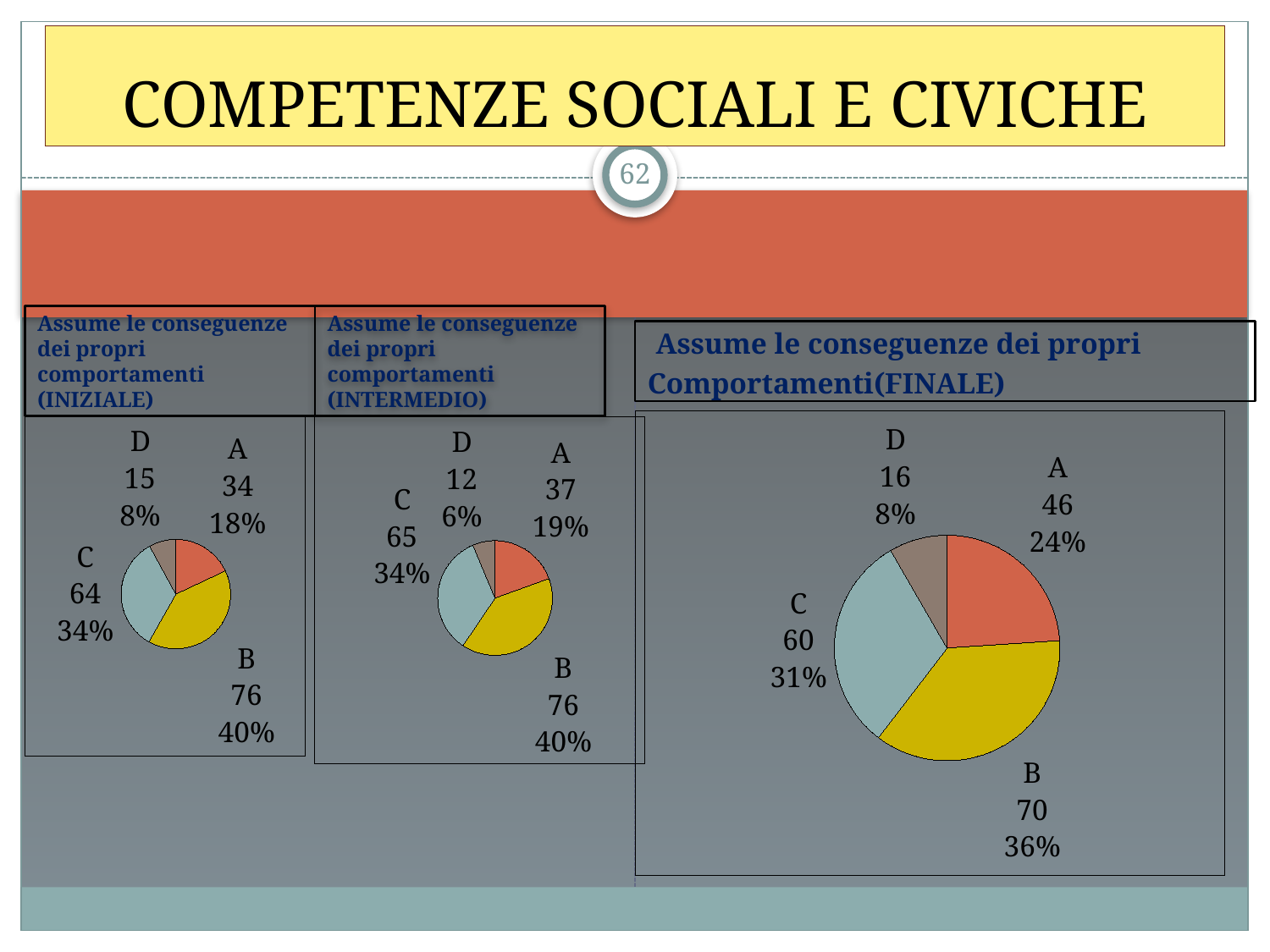
In the FINALE pie chart, what is the difference between the counts for B and A? 24 In the INIZIALE pie chart, what is the count for category B? 76 How many categories does the FINALE pie chart show? 4 In the INTERMEDIO pie chart, what is the count for category A? 37 What type of chart is used for the INIZIALE, INTERMEDIO and FINALE data? Pie chart In the FINALE pie chart, what is the count for category C? 60 In the FINALE pie chart, which is larger, the count for C or the count for D? C In the INTERMEDIO pie chart, what percentage is shown for category D? 6% In the INIZIALE pie chart, which category has the smallest slice? D In the INIZIALE pie chart, what share of the pie does category C represent? 34% In the INTERMEDIO pie chart, which category has the largest slice? B In the FINALE pie chart, what percentage is shown for category A? 24%